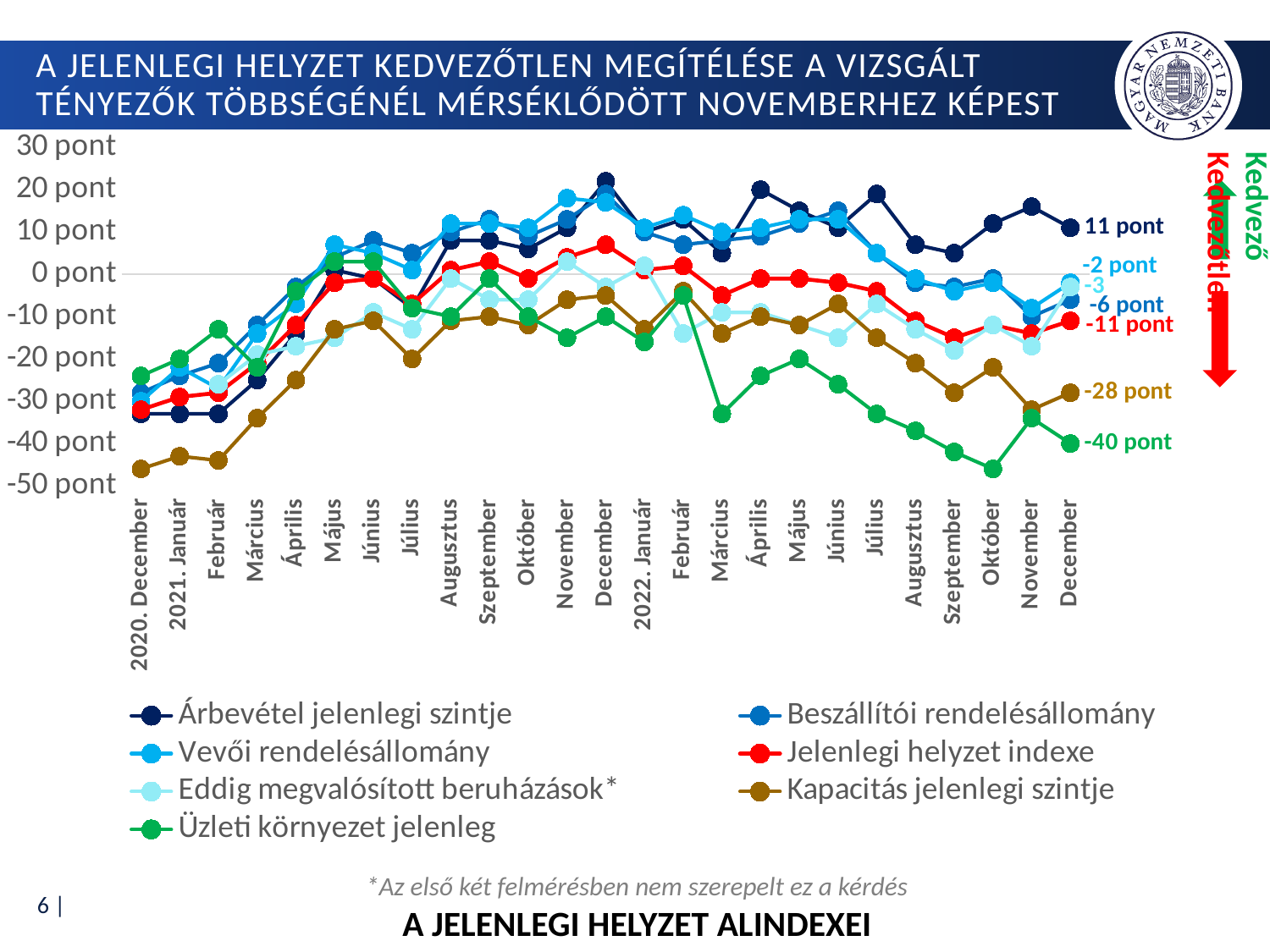
What is the value of Üzleti környezet jelenleg at the last point (2022 December)? -40 pont What is the difference between the final values of Árbevétel jelenlegi szintje (11 pont) and Üzleti környezet jelenleg (-40 pont)? 51 pont Does the Üzleti környezet jelenleg series rise or fall between 2022 Február and 2022 Október? fall What is the value of Kapacitás jelenlegi szintje at the last point (2022 December)? -28 pont What kind of chart is shown on the slide? line chart Which series has the highest value at the last point (2022 December)? Árbevétel jelenlegi szintje How many series does the legend list? 7 Is the value for Kapacitás jelenlegi szintje in 2020 December greater or less than -40 pont? less What is the value of Jelenlegi helyzet indexe at the last point (2022 December)? -11 pont At the last point (2022 December), which is larger: Kapacitás jelenlegi szintje or Jelenlegi helyzet indexe? Jelenlegi helyzet indexe What is the value of Árbevétel jelenlegi szintje at the last point (2022 December)? 11 pont Which series has the lowest value at the last point (2022 December)? Üzleti környezet jelenleg